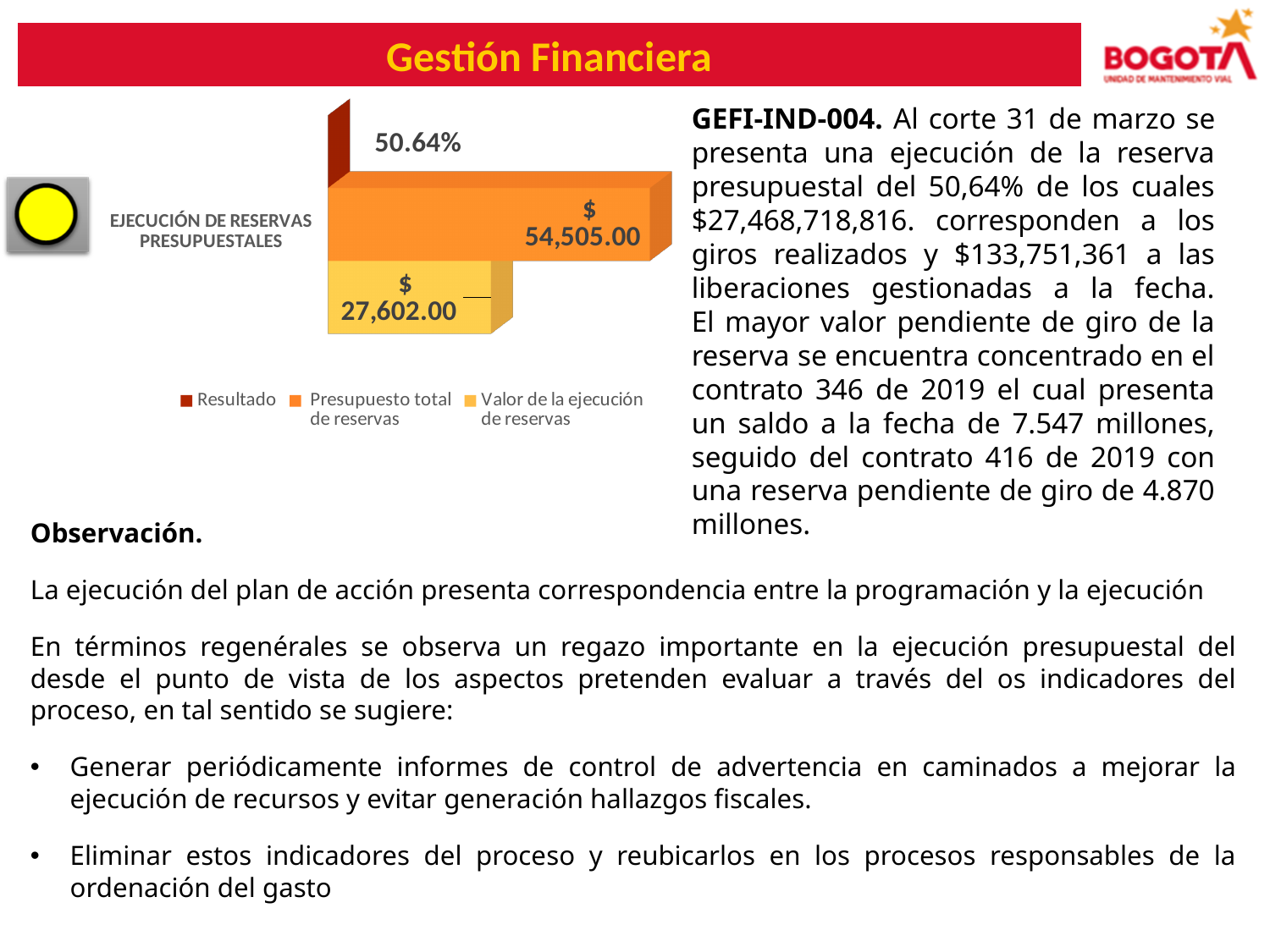
What is the value shown for the 'Presupuesto total de reservas' series? $ 54,505.00 How many series does the chart legend list? 3 Which is larger, 'Presupuesto total de reservas' or 'Valor de la ejecución de reservas'? Presupuesto total de reservas What is the difference between 'Presupuesto total de reservas' and 'Valor de la ejecución de reservas'? $ 26,903.00 Which colour represents the 'Valor de la ejecución de reservas' series in the legend? Yellow What is the value shown for the 'Resultado' series? 50.64% What is the category label shown on the chart? EJECUCIÓN DE RESERVAS PRESUPUESTALES Which of the two dollar-valued series has the lowest value? Valor de la ejecución de reservas What kind of chart is shown on the slide? Bar chart What is the value shown for the 'Valor de la ejecución de reservas' series? $ 27,602.00 How many categories are plotted on the chart? 1